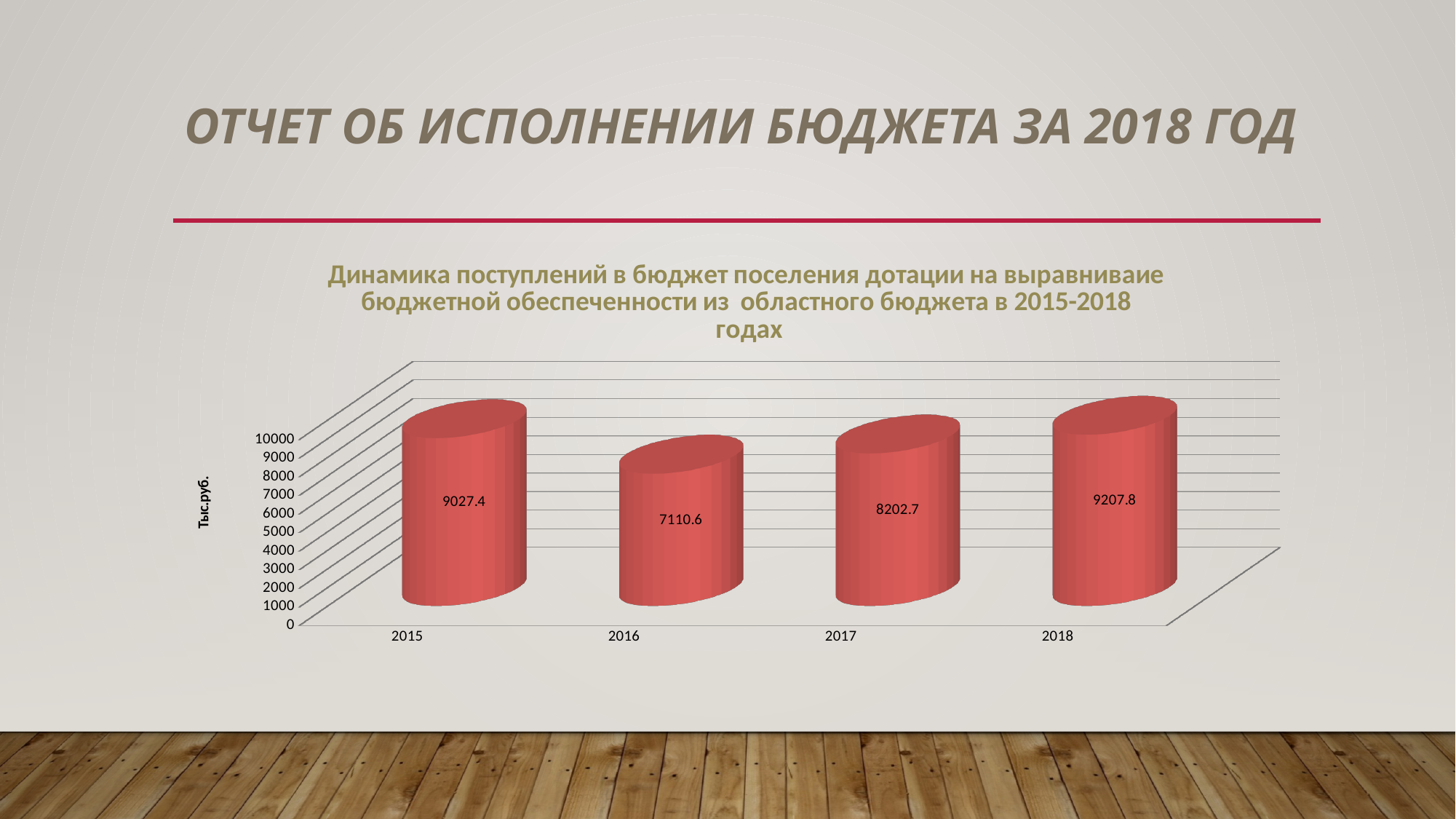
Which year has the lowest value? 2016 What is the label on the vertical axis of the chart? Тыс.руб. What is the value for 2018? 9207.8 What is the difference between the values for 2015 and 2016? 1916.8 Which is larger, the value for 2017 or the value for 2016? 2017 How many years are shown on the chart? 4 What kind of chart is shown on the slide? Bar chart What is the difference between the values for 2018 and 2015? 180.4 Which year has the highest value? 2018 What is the value for 2016? 7110.6 What is the value for 2015? 9027.4 What is the value for 2017? 8202.7